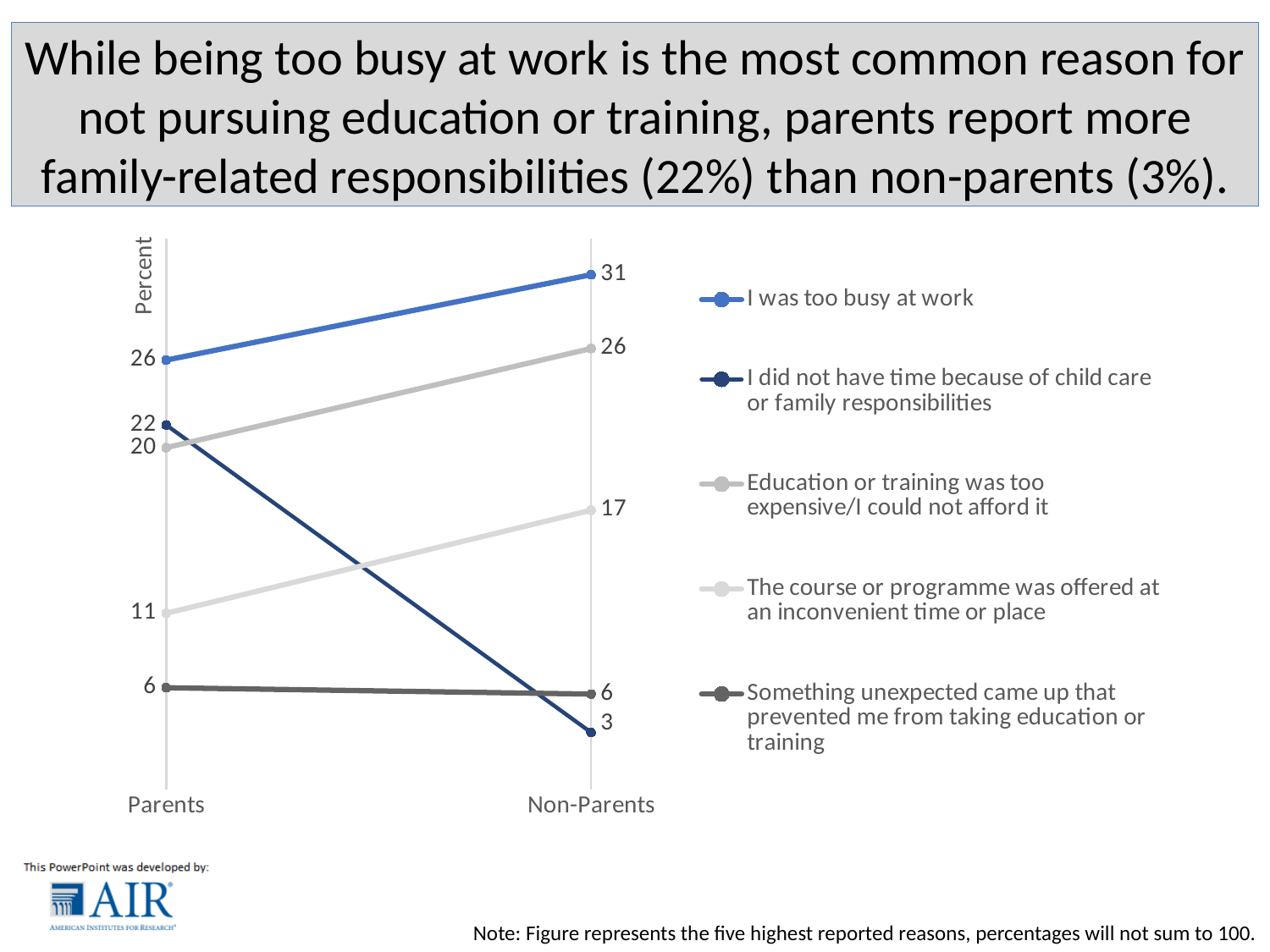
What is the value for Non-Parents for 'I did not have time because of child care or family responsibilities'? 3 Which is larger for Parents: 'Education or training was too expensive/I could not afford it' or 'The course or programme was offered at an inconvenient time or place'? Education or training was too expensive/I could not afford it How many categories are shown on the x axis? 2 What is the difference between Parents and Non-Parents for 'I did not have time because of child care or family responsibilities'? 19 What is the value for Non-Parents for 'The course or programme was offered at an inconvenient time or place'? 17 Does the value for 'I was too busy at work' rise or fall from Parents to Non-Parents? rise What kind of chart is shown on the slide? line chart Which series has the highest value for Non-Parents? I was too busy at work What is the value for Parents for 'I was too busy at work'? 26 How many series does the legend list? 5 What is the value for Parents for 'Education or training was too expensive/I could not afford it'? 20 Which series has the lowest value for Non-Parents? I did not have time because of child care or family responsibilities